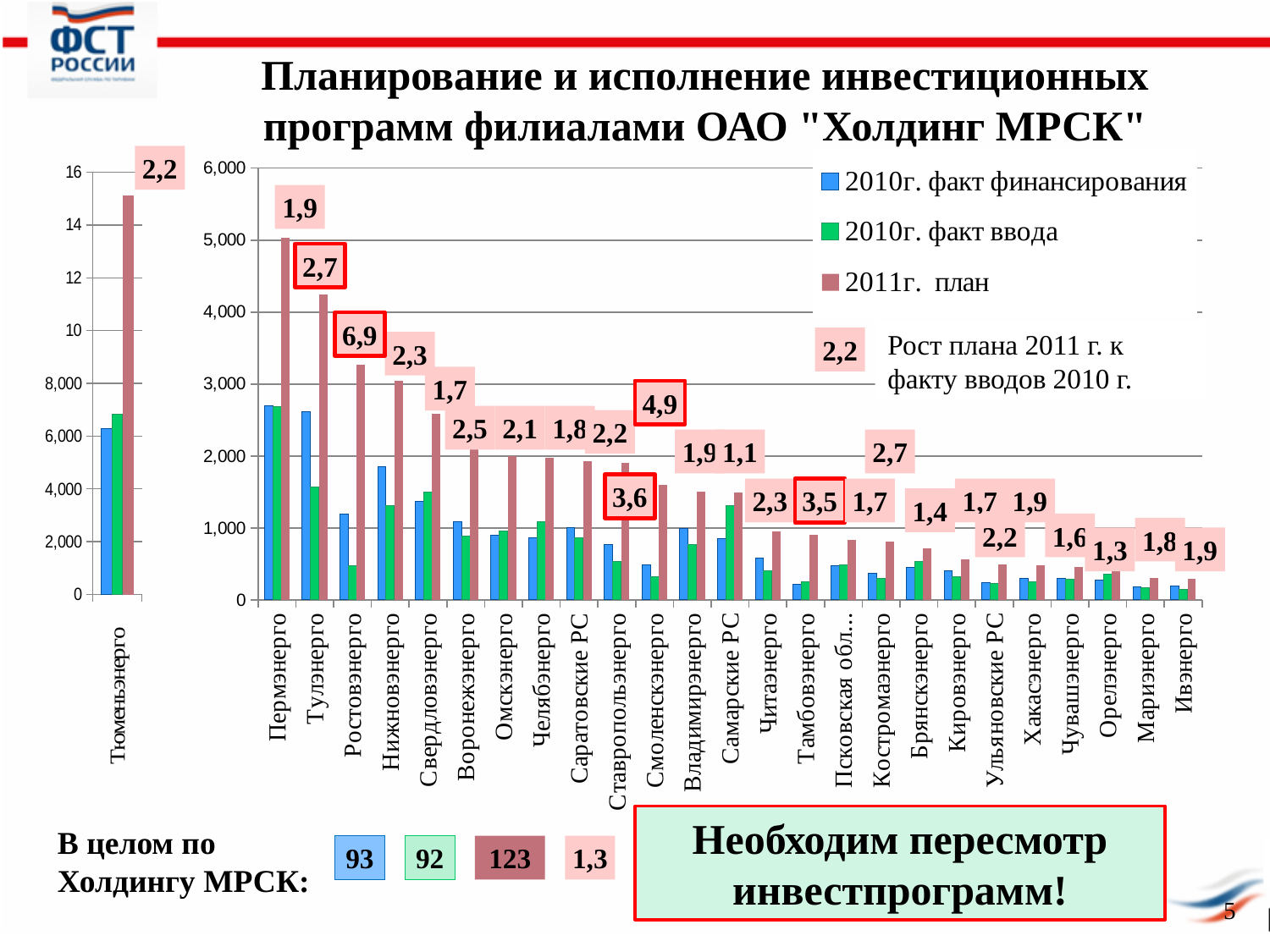
Which series in the large chart's legend is shown in green? 2010г. факт ввода How many branches (categories) are shown on the x axis of the large chart? 25 How many series does the legend of the large chart list? 3 In the large chart, is the 2010г. факт финансирования value for Пермэнерго greater or less than 2,000? greater In the small chart on the left for Тюменьэнерго, is the 2010г. факт финансирования value greater or less than 8,000? less In the large chart, which is larger: the 2011г. план bar for Пермэнерго or for Тулаэнерго? Пермэнерго In the large chart, is the 2011г. план value for Ивэнерго greater or less than 1,000? less In the large chart, do the 2011г. план values generally rise or fall from left to right along the x axis? fall What kind of chart is the large chart on the right of the slide? bar chart In the large chart, which branch has the highest 2011г. план bar? Пермэнерго